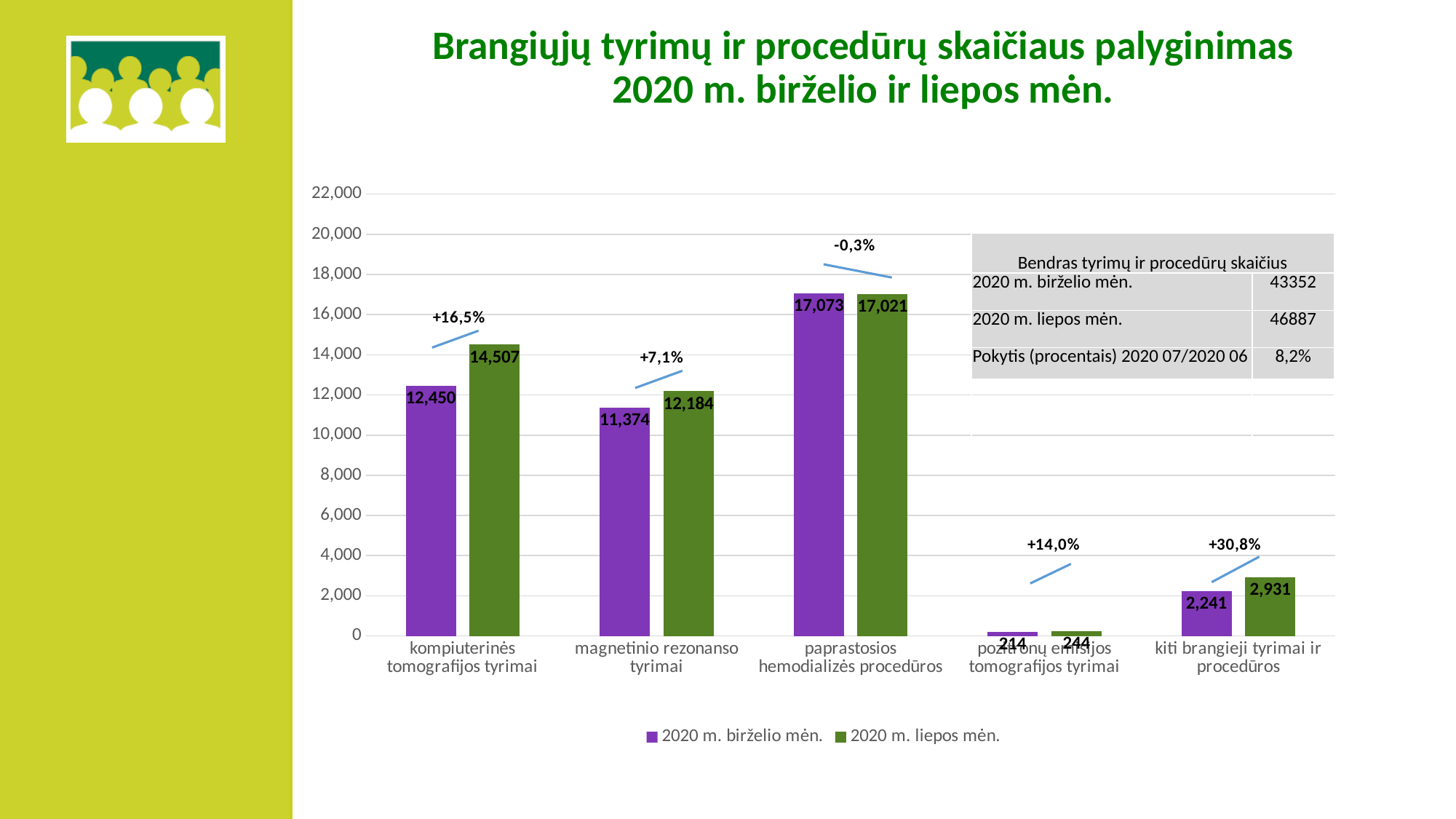
What is the value for magnetinio rezonanso tyrimai in 2020 m. birželio mėn.? 11,374 What type of chart is shown on the slide? bar chart What is the value for kompiuterinės tomografijos tyrimai in 2020 m. liepos mėn.? 14,507 What is the difference between the 2020 m. liepos mėn. and 2020 m. birželio mėn. values for kiti brangieji tyrimai ir procedūros? 690 For paprastosios hemodializės procedūros, which is larger: the 2020 m. birželio mėn. value or the 2020 m. liepos mėn. value? 2020 m. birželio mėn. What percentage change is labelled above the bars for kiti brangieji tyrimai ir procedūros? +30,8% What colour are the bars for 2020 m. liepos mėn.? green Which category has the lowest value for 2020 m. liepos mėn.? pozitronų emisijos tomografijos tyrimai How many categories are shown on the x axis? 5 How many series does the legend list? 2 What is the value for pozitronų emisijos tomografijos tyrimai in 2020 m. liepos mėn.? 244 Which category has the highest value for 2020 m. birželio mėn.? paprastosios hemodializės procedūros